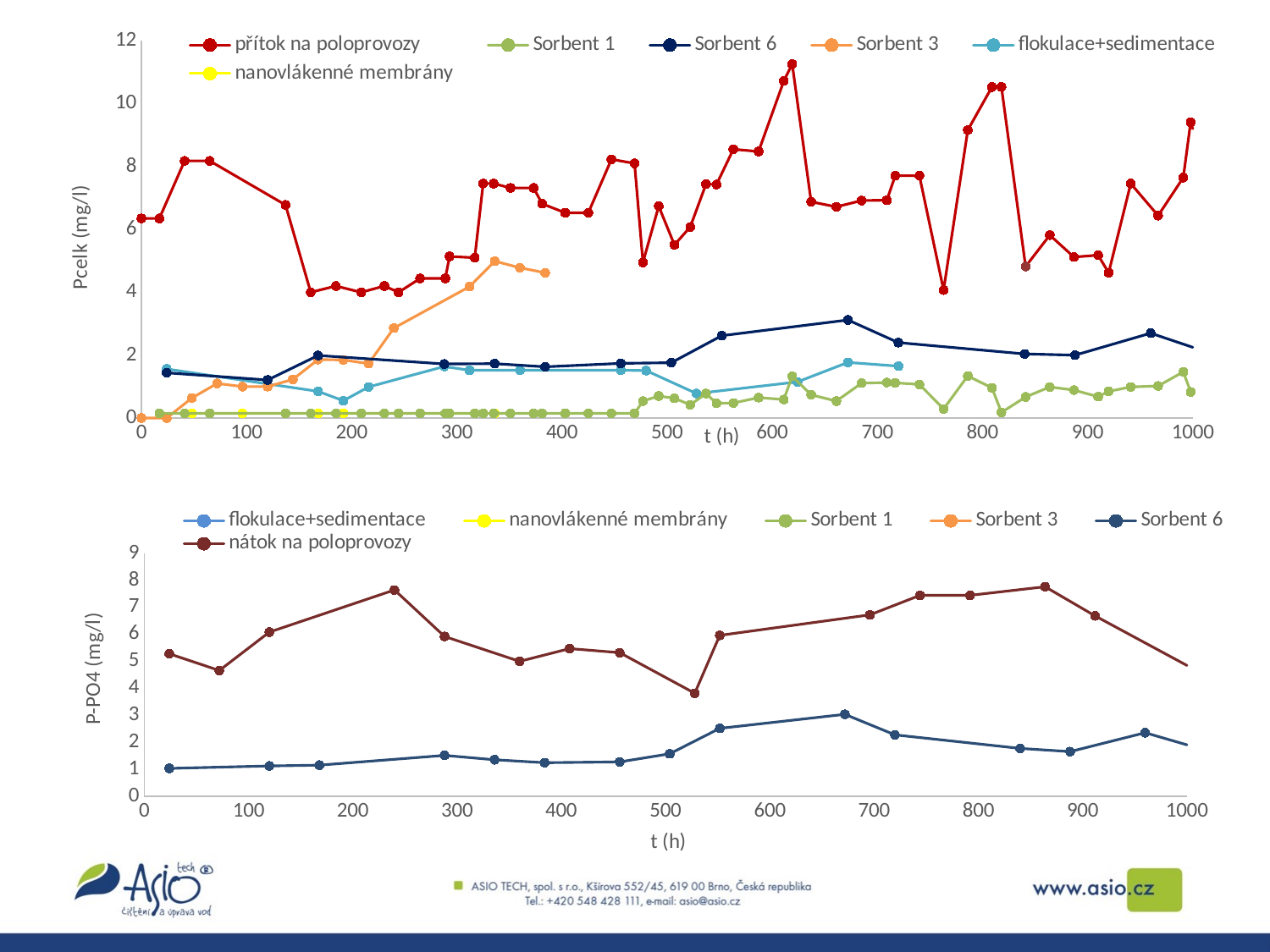
In the top chart (Pcelk), is the peak value of přítok na poloprovozy around 620 h greater or less than 10? greater In the bottom chart (P-PO4), does the nátok na poloprovozy line rise or fall between about 860 h and 1000 h? fall How many series does the legend of the top chart (Pcelk) list? 6 In the top chart (Pcelk), which series reaches the highest values? přítok na poloprovozy How many series does the legend of the bottom chart (P-PO4) list? 6 What is the y-axis title of the top chart? Pcelk (mg/l) In the bottom chart (P-PO4), is the value of Sorbent 6 at about 670 h greater or less than 4? less In the top chart, at 1000 h, which series has the larger value, přítok na poloprovozy or Sorbent 6? přítok na poloprovozy What is the y-axis title of the bottom chart? P-PO4 (mg/l) In the bottom chart (P-PO4), which series has the higher values, nátok na poloprovozy or Sorbent 6? nátok na poloprovozy What kind of chart is the top chart on the slide? line chart In the bottom chart (P-PO4), is the value of nátok na poloprovozy at about 860 h greater or less than 7? greater